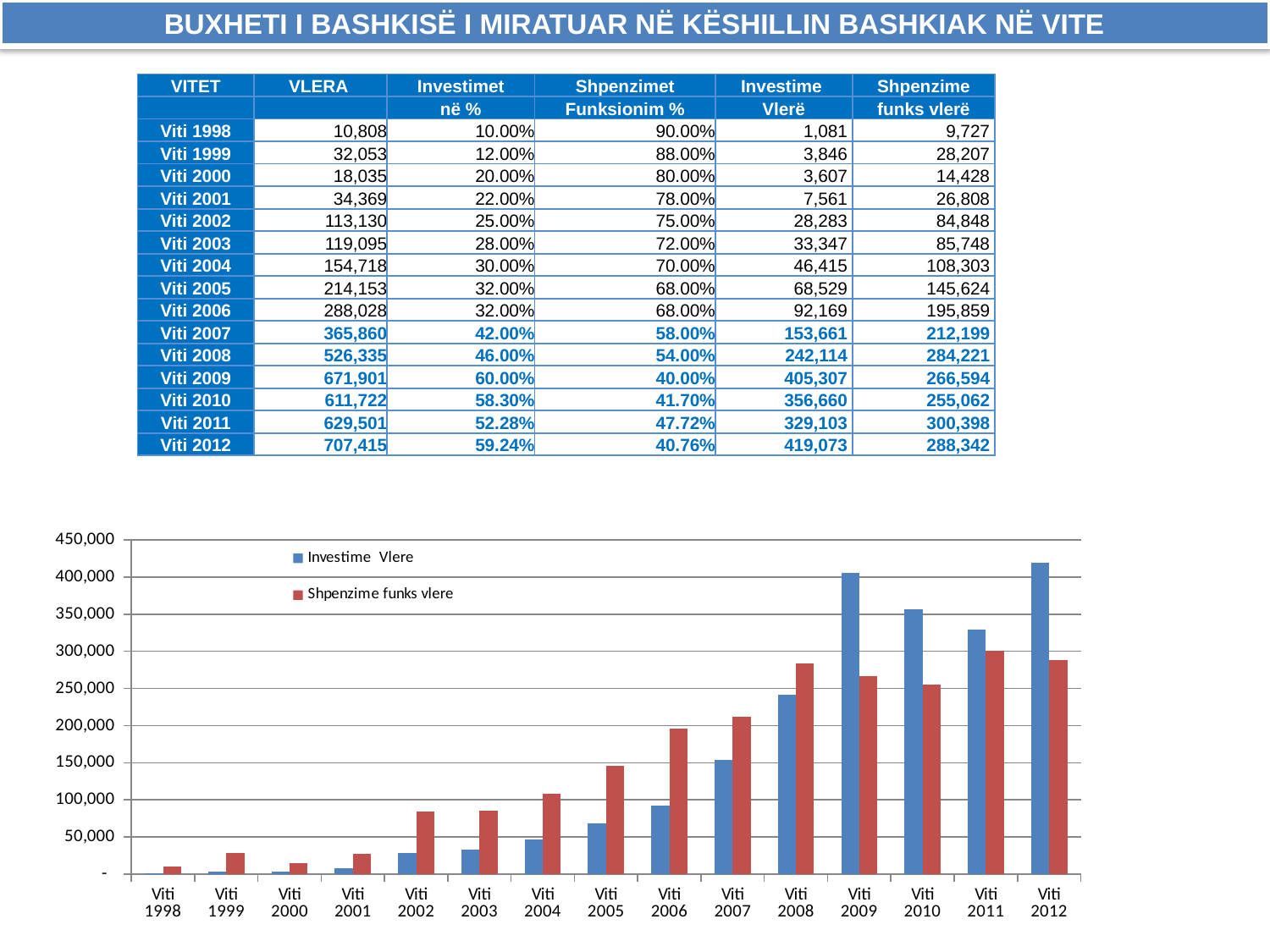
For Viti 2008, which is larger: Investime Vlere or Shpenzime funks vlere? Shpenzime funks vlere In which year is the Shpenzime funks vlere bar the highest? Viti 2011 In which year is the Investime Vlere bar the highest? Viti 2012 How many series does the chart legend list? 2 Do the Investime Vlere bars rise or fall from Viti 1998 to Viti 2009? rise What kind of chart is shown on the slide? bar chart Is the Investime Vlere value for Viti 2005 greater or less than 100,000? less Is the Investime Vlere value for Viti 2012 greater or less than 400,000? greater How many years are shown on the x axis of the chart? 15 What is the Investime Vlere value for Viti 2012? 419,073 What is the Shpenzime funks vlere value for Viti 2011? 300,398 What is the difference between Investime Vlere and Shpenzime funks vlere for Viti 2012? 130,731